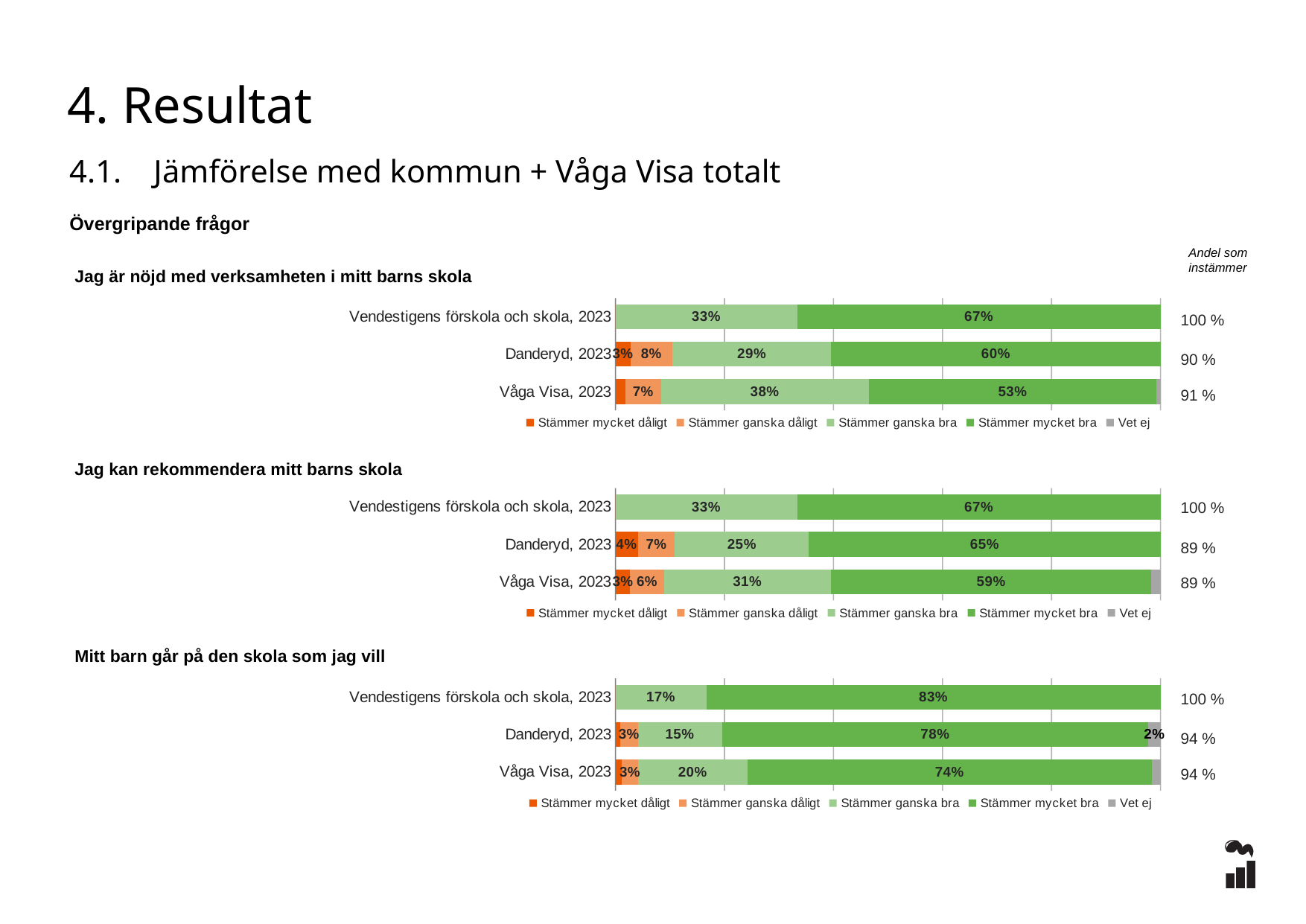
What kind of chart is used for 'Jag kan rekommendera mitt barns skola'? Stacked bar chart In the chart 'Mitt barn går på den skola som jag vill', what is the 'Vet ej' value for Danderyd, 2023? 2% How many series does the legend of the chart 'Jag är nöjd med verksamheten i mitt barns skola' list? 5 How many rows (categories) does the chart 'Mitt barn går på den skola som jag vill' show? 3 In the chart 'Mitt barn går på den skola som jag vill', what is the 'Stämmer mycket bra' value for Vendestigens förskola och skola, 2023? 83% In the chart 'Jag kan rekommendera mitt barns skola', what is the difference between the 'Stämmer mycket bra' values for Danderyd, 2023 and Våga Visa, 2023? 6% In the chart 'Jag är nöjd med verksamheten i mitt barns skola', what is the 'Stämmer ganska bra' value for Våga Visa, 2023? 38% In the chart 'Jag kan rekommendera mitt barns skola', which row has the highest 'Stämmer mycket bra' value? Vendestigens förskola och skola, 2023 In the chart 'Jag är nöjd med verksamheten i mitt barns skola', what is the 'Stämmer mycket bra' value for Vendestigens förskola och skola, 2023? 67% In the chart 'Jag är nöjd med verksamheten i mitt barns skola', what is the 'Andel som instämmer' value shown for Danderyd, 2023? 90 % In the chart 'Jag kan rekommendera mitt barns skola', what is the 'Stämmer ganska dåligt' value for Danderyd, 2023? 7% In the chart 'Mitt barn går på den skola som jag vill', which is larger: the 'Stämmer ganska bra' value for Danderyd, 2023 or for Våga Visa, 2023? Våga Visa, 2023